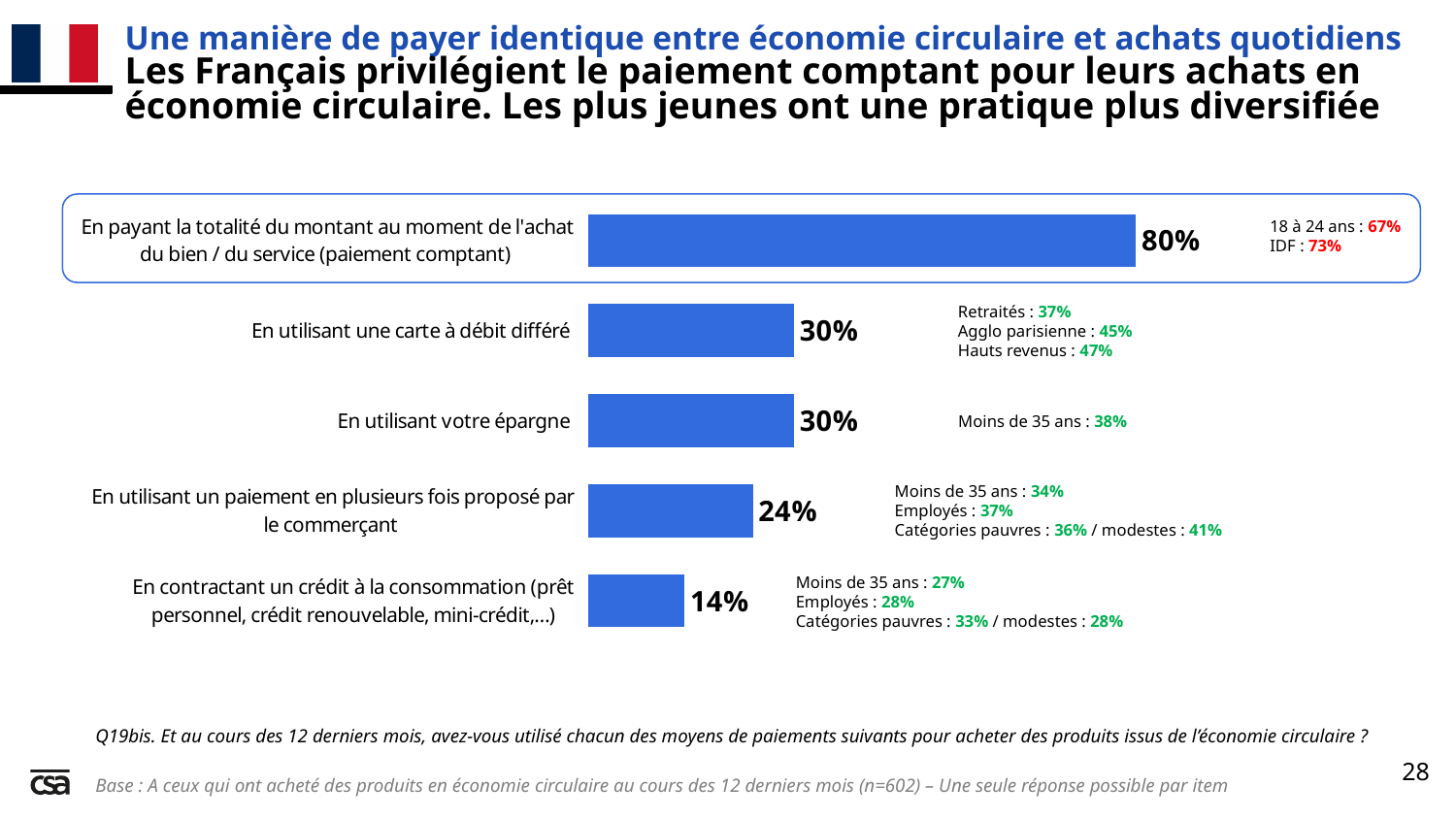
Which is larger: the value for "En utilisant votre épargne" or the value for "En contractant un crédit à la consommation"? En utilisant votre épargne Do the values rise or fall going from the top bar to the bottom bar? Fall What type of chart is shown on the slide? Bar chart Which payment method has the lowest value? En contractant un crédit à la consommation (prêt personnel, crédit renouvelable, mini-crédit,...) How many payment methods are shown in the chart? 5 What is the value for "En utilisant un paiement en plusieurs fois proposé par le commerçant"? 24% What is the value for "En utilisant une carte à débit différé"? 30% What percentage of respondents pay the full amount at the time of purchase (paiement comptant)? 80% What is the value for "En contractant un crédit à la consommation"? 14% What is the difference between the value for "En utilisant votre épargne" and the value for "paiement en plusieurs fois"? 6 percentage points What is the difference between the value for paiement comptant and the value for crédit à la consommation? 66 percentage points Which payment method has the highest value? En payant la totalité du montant au moment de l'achat du bien / du service (paiement comptant)